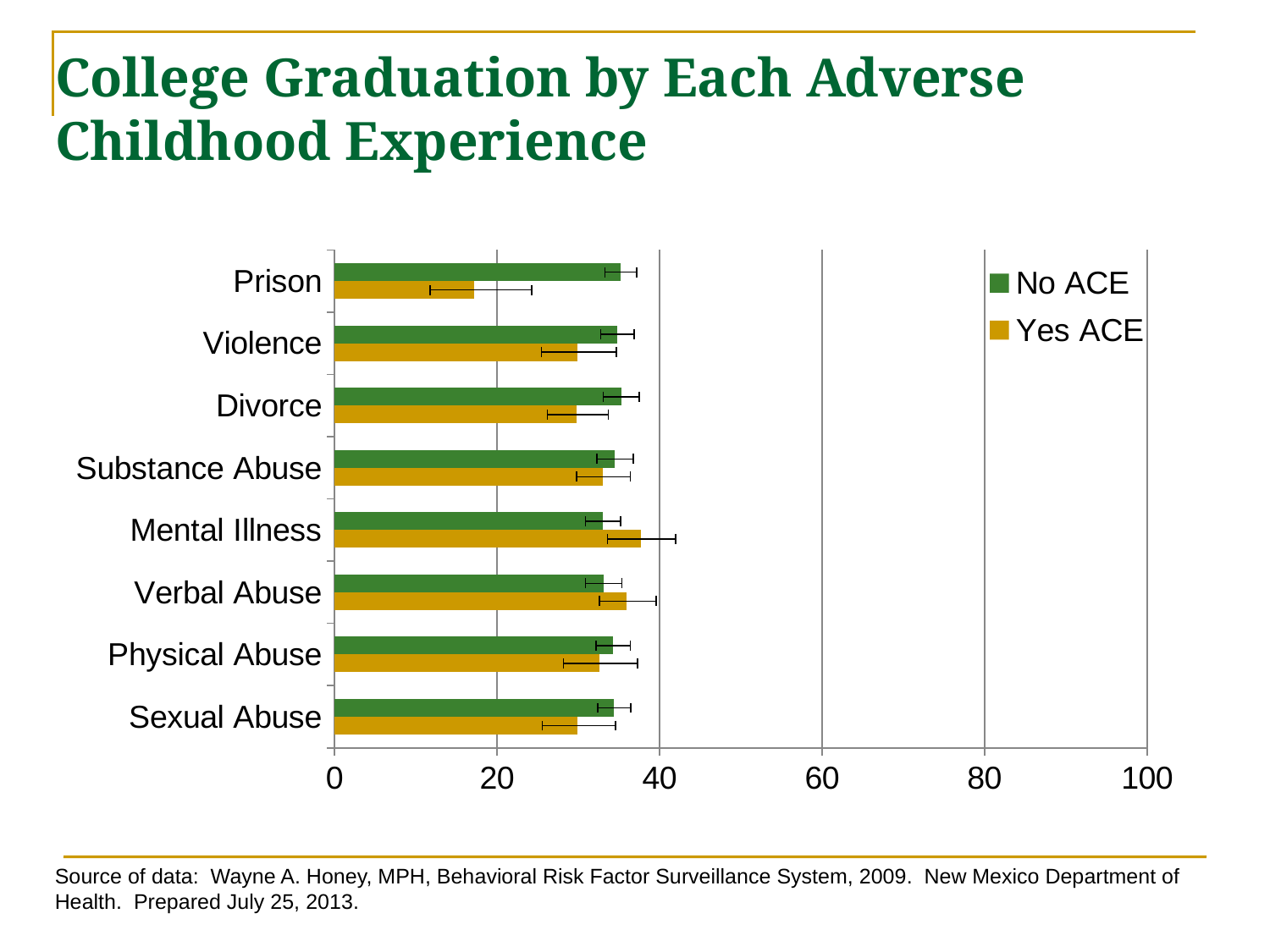
For Prison, which is larger: the No ACE value or the Yes ACE value? No ACE How many series does the legend list? 2 Is the Yes ACE value for Divorce greater or less than 20? greater Is the Yes ACE value for Mental Illness greater or less than 40? less Is the No ACE value for Prison greater or less than 20? greater For Mental Illness, which is larger: the No ACE value or the Yes ACE value? Yes ACE How many adverse childhood experience categories are plotted on the chart? 8 What kind of chart is shown on the slide? bar chart What is the title of the chart on the slide? College Graduation by Each Adverse Childhood Experience Which category has the lowest Yes ACE value? Prison Which colour represents the Yes ACE series in the legend? gold